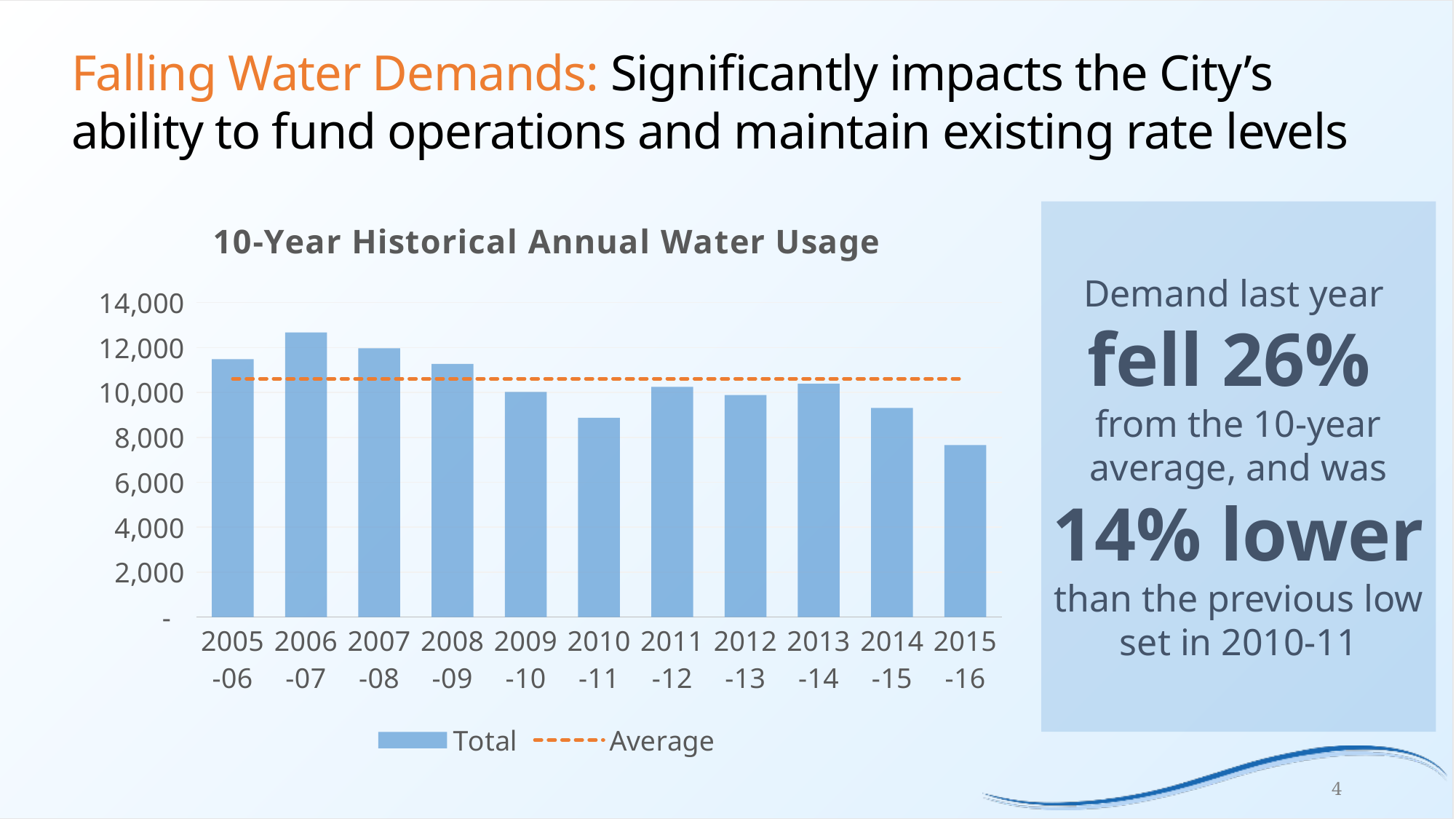
What does the orange dashed line in the chart represent? Average Overall, does total water usage rise or fall from 2005-06 to 2015-16? Fall How many series does the chart legend list? 2 Which fiscal year has the lowest total water usage? 2015-16 Which fiscal year has the highest total water usage? 2006-07 Which has the larger total water usage, 2007-08 or 2009-10? 2007-08 Is the total water usage for 2010-11 greater or less than 10,000? less Is the total water usage for 2015-16 greater or less than 8,000? less Is the total water usage for 2006-07 greater or less than 12,000? greater What is the title of the chart? 10-Year Historical Annual Water Usage How many fiscal years are plotted as bars in the chart? 11 What type of chart is shown on the slide? Bar chart